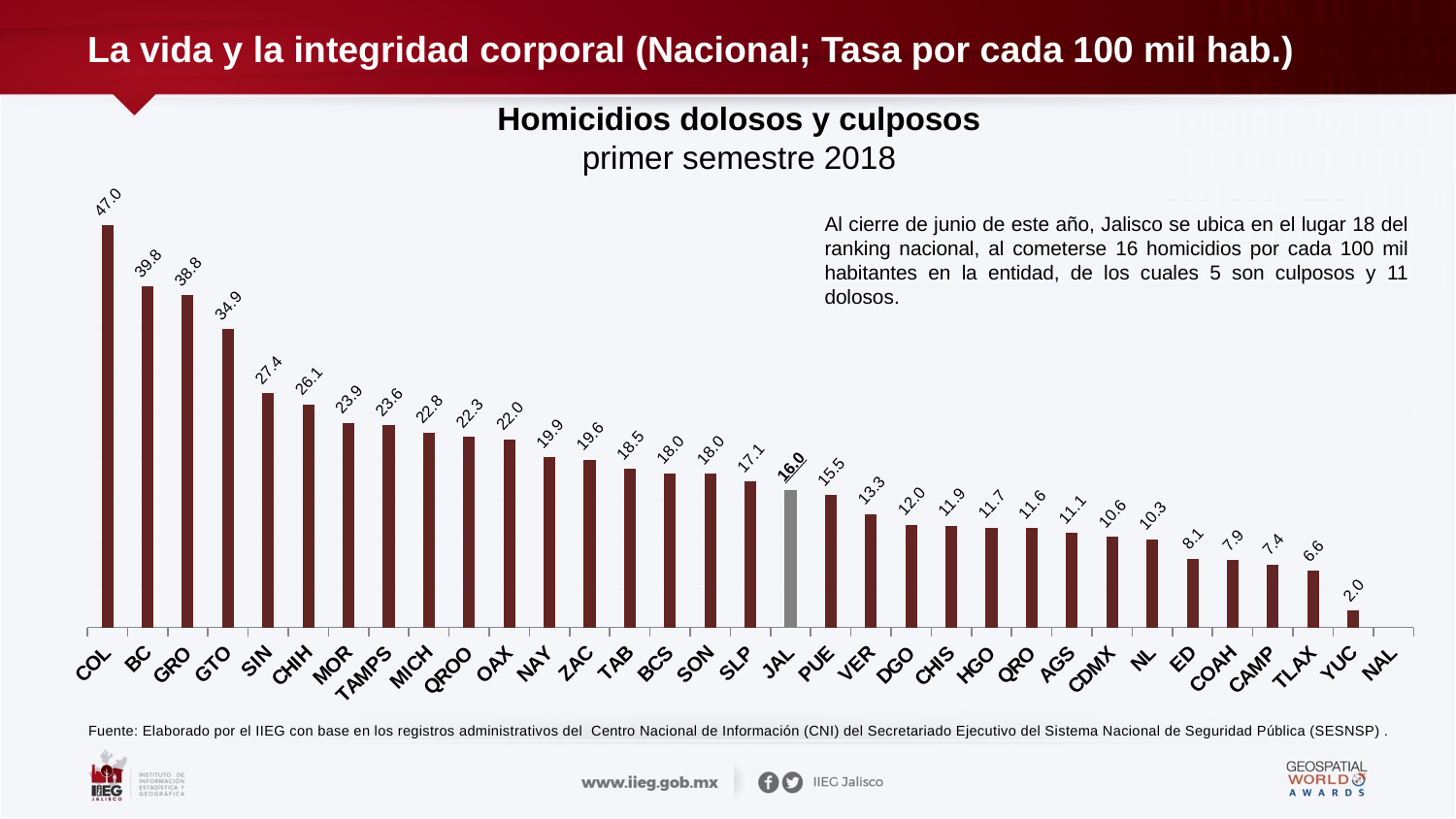
What is the value for JAL? 16.0 What is the value for YUC? 2.0 What kind of chart is shown? Bar chart What is the value for COL? 47.0 Which is larger, the value for SIN or the value for CHIH? SIN What is the value for CDMX? 10.6 What is the difference between the values for JAL and PUE? 0.5 What is the difference between the values for COL and BC? 7.2 Which state has the highest value? COL Which bar is coloured grey instead of dark red? JAL Which state has the lowest value among the bars shown? YUC Do the values rise or fall from left to right along the x axis? Fall